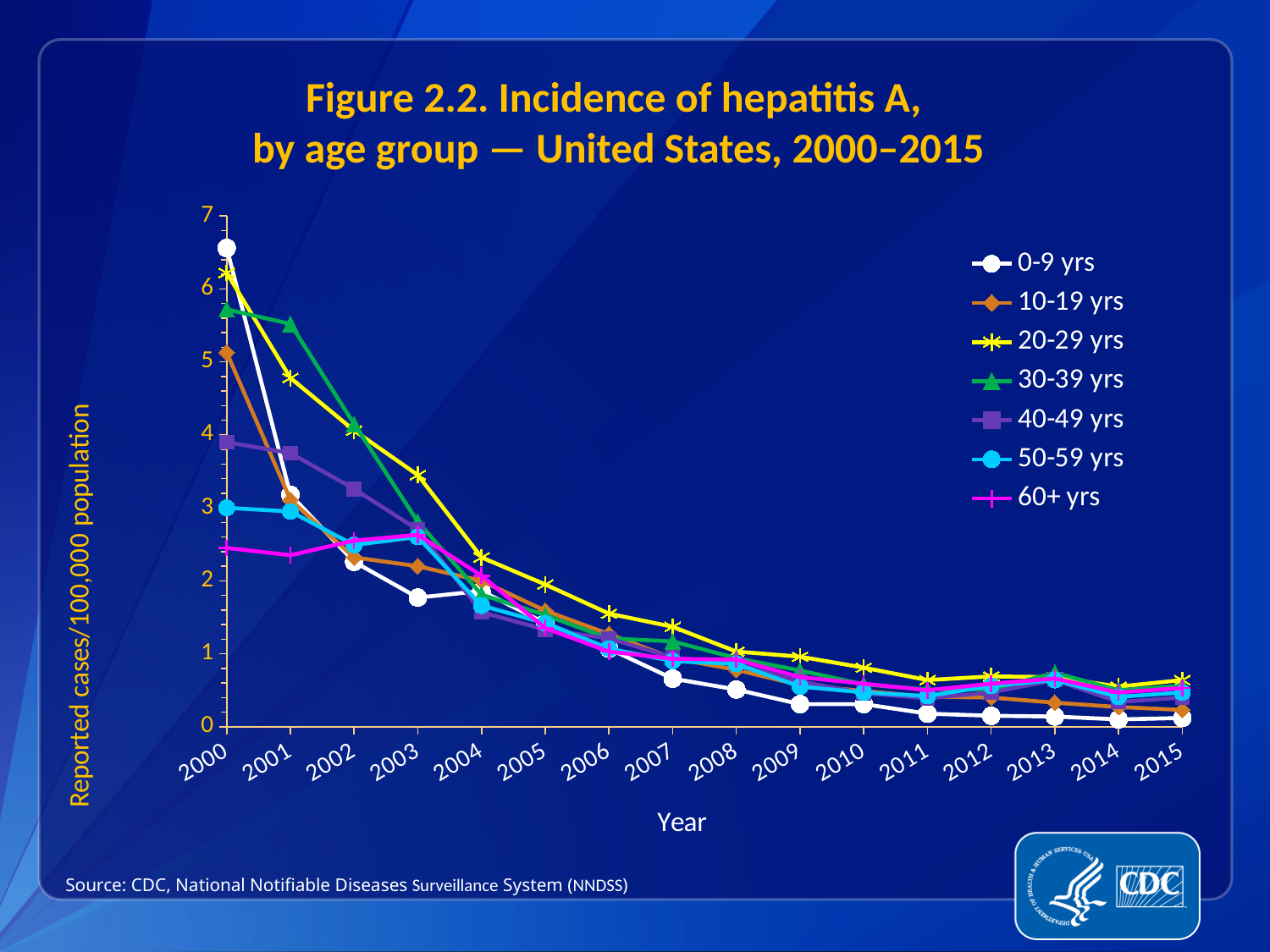
Does the incidence for the 0-9 yrs group rise or fall from 2000 to 2015? Fall Which age group had the lowest incidence in 2015? 0-9 yrs Is the incidence for the 0-9 yrs group in 2007 greater or less than 1? less In 2003, which had the higher incidence: the 20-29 yrs group or the 0-9 yrs group? 20-29 yrs Is the incidence for the 0-9 yrs group in 2000 greater or less than 6? greater Which age group had the highest incidence of hepatitis A in 2000? 0-9 yrs How many age groups does the legend list? 7 Is the incidence for the 60+ yrs group in 2000 greater or less than 3? less Which age group had the highest incidence in 2001? 30-39 yrs Which age group had the lowest incidence of hepatitis A in 2000? 60+ yrs How many years are plotted along the x axis? 16 What kind of chart is shown on the slide? Line chart